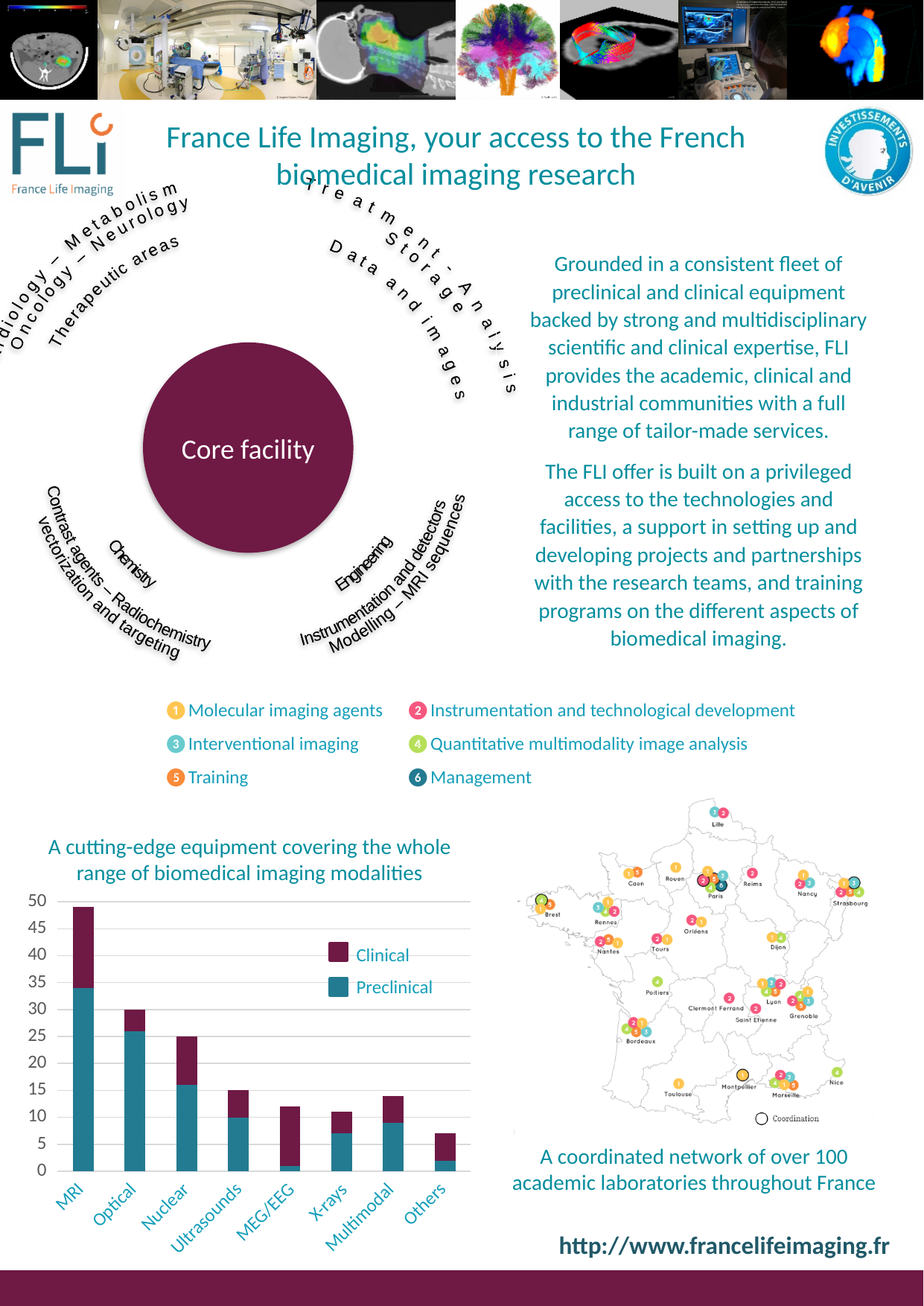
Is the Preclinical value for MEG/EEG in the bar chart greater or less than 5? less How many series does the legend of the bar chart list? 2 Is the total value for MRI in the bar chart greater or less than 45? greater What kind of chart is shown under the heading 'A cutting-edge equipment covering the whole range of biomedical imaging modalities'? Bar chart In the bar chart, which has the larger total bar, Optical or Nuclear? Optical In the bar chart, which has the larger Preclinical value, MRI or Optical? MRI Which modality has the highest total bar in the bar chart? MRI Is the Preclinical value for X-rays in the bar chart greater or less than 10? less How many imaging modality categories are shown on the x axis of the bar chart? 8 Which modality has the lowest total bar in the bar chart? Others Which series are listed in the legend of the bar chart? Clinical and Preclinical What is the title of the bar chart on the slide? A cutting-edge equipment covering the whole range of biomedical imaging modalities